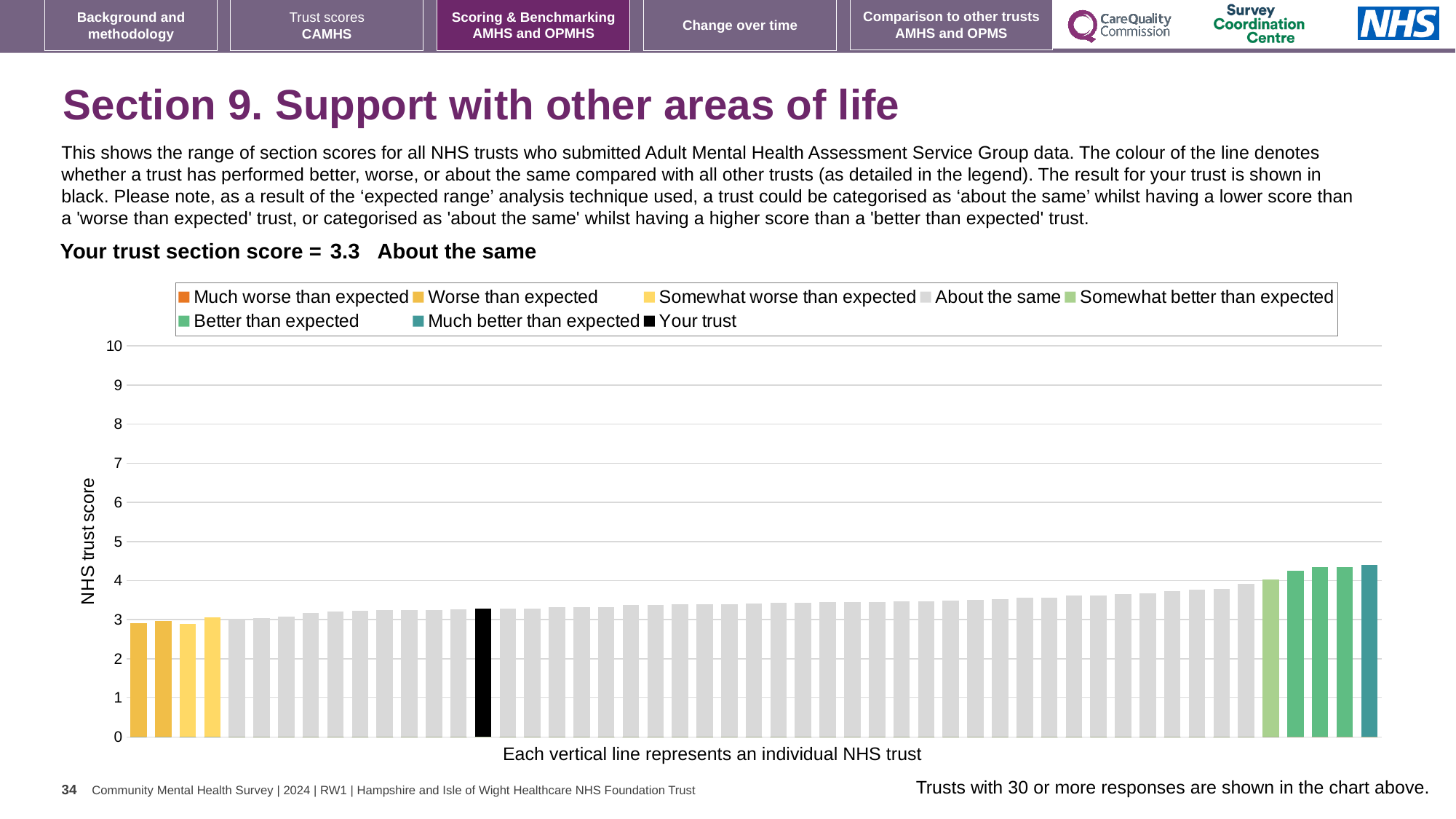
Is the value of the leftmost (lowest) bar greater or less than 3? less Is the value of the black 'Your trust' bar greater or less than 4? less What kind of chart is shown on the slide? bar chart Do the bar values rise or fall moving from left to right across the chart? rise What is the section score for your trust shown on the slide? 3.3 What is the label on the vertical axis of the chart? NHS trust score How many entries does the chart legend list? 8 Which performance category is your trust placed in for this section? About the same Which legend category does the tallest bar in the chart belong to? Much better than expected Is the value of the tallest bar in the chart greater or less than 4? greater How many bars are coloured as 'Much better than expected'? 1